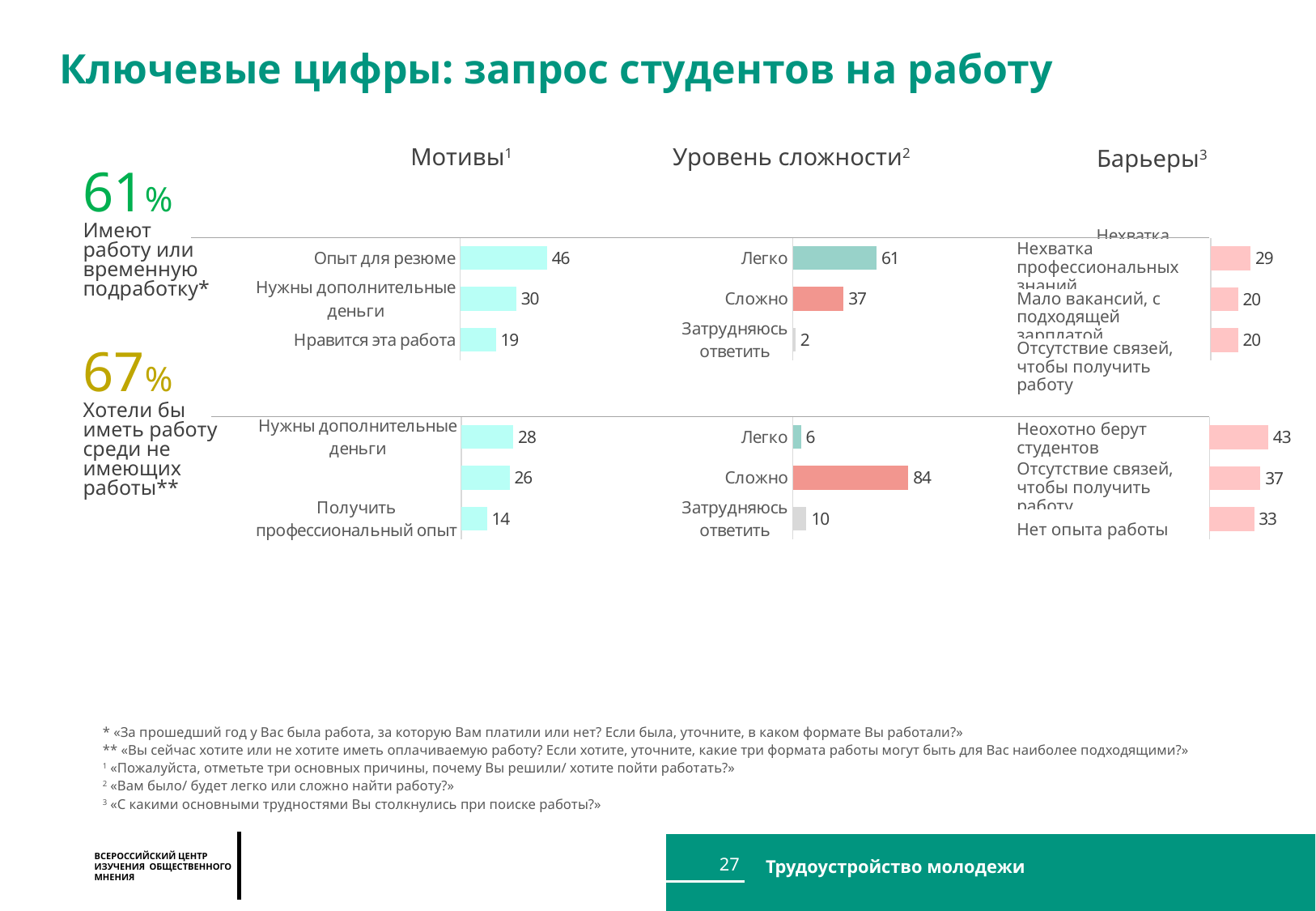
In the bottom-row 'Барьеры' chart (for those who would like a job), which is larger: 'Неохотно берут студентов' or 'Нет опыта работы'? Неохотно берут студентов In the bottom-row 'Мотивы' chart (for those who would like a job), what is the value for 'Получить профессиональный опыт'? 14 In the top-row 'Уровень сложности' chart (for those who have a job), what is the difference between 'Легко' and 'Сложно'? 24 In the bottom-row 'Барьеры' chart (for those who would like a job), what is the value for 'Нет опыта работы'? 33 In the top-row 'Мотивы' chart (for those who have a job), what is the value for 'Опыт для резюме'? 46 In the top-row 'Уровень сложности' chart (for those who have a job), what is the value for 'Сложно'? 37 In the bottom-row 'Уровень сложности' chart (for those who would like a job), which category has the lowest value? Легко In the top-row 'Барьеры' chart (for those who have a job), what is the value for 'Нехватка профессиональных знаний'? 29 How many bars are in the top-row 'Мотивы' chart (for those who have a job)? 3 What type of chart is used in the 'Уровень сложности' column? Bar chart In the bottom-row 'Уровень сложности' chart (for those who would like a job), which category has the highest value? Сложно In the bottom-row 'Уровень сложности' chart (for those who would like a job), what is the difference between 'Сложно' and 'Затрудняюсь ответить'? 74